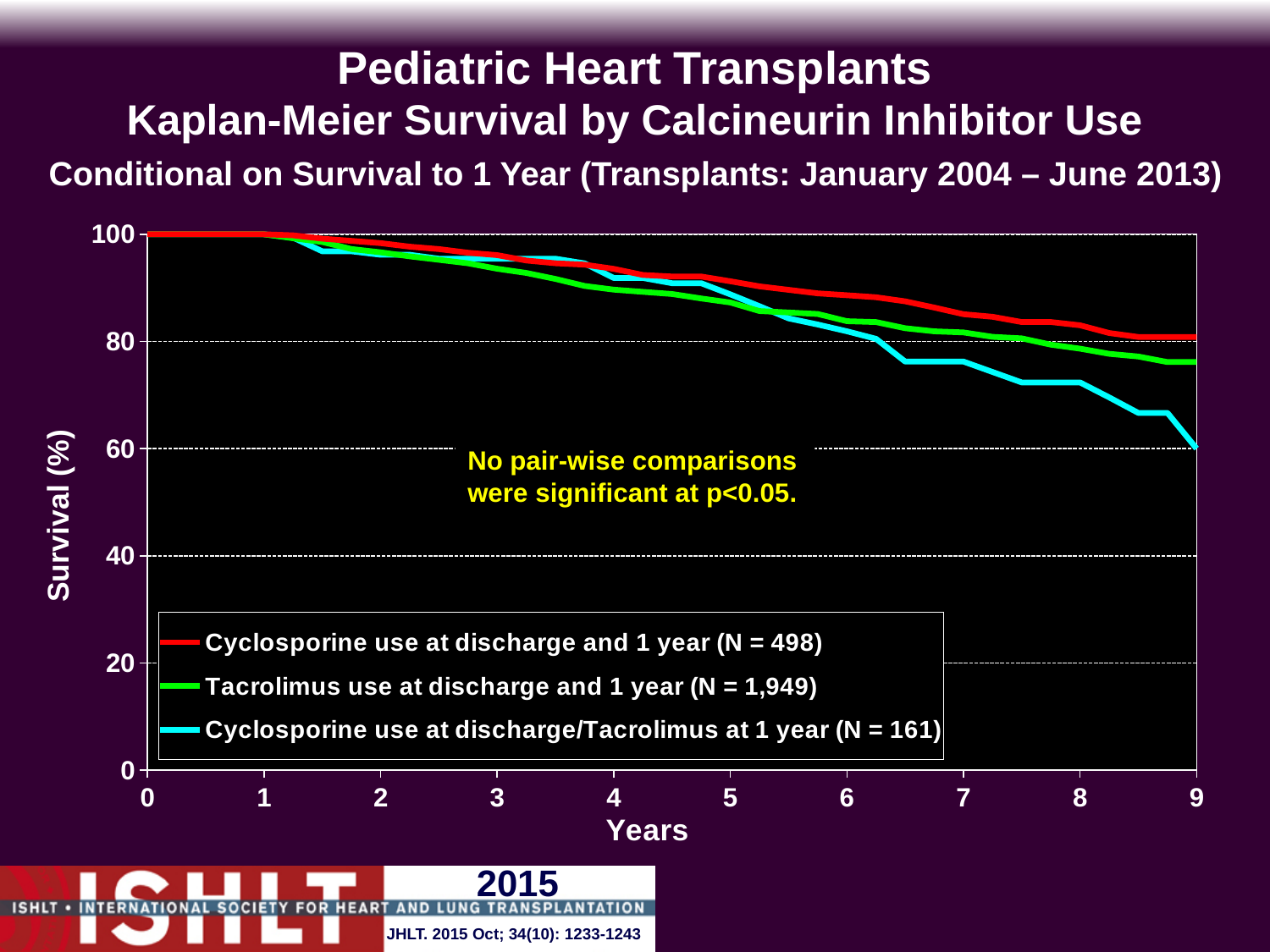
At 9 years, is survival for the Tacrolimus use at discharge and 1 year group greater or less than 80%? less Which series has the lowest survival at 9 years? Cyclosporine use at discharge/Tacrolimus at 1 year (N = 161) At 8 years, which group has higher survival: Tacrolimus use at discharge and 1 year, or Cyclosporine use at discharge/Tacrolimus at 1 year? Tacrolimus use at discharge and 1 year What kind of chart is shown on the slide? Line chart At 5 years, is survival for the Cyclosporine use at discharge and 1 year group greater or less than 80%? greater What is the N for the Tacrolimus use at discharge and 1 year group shown in the legend? N = 1,949 At 8 years, is survival for the Cyclosporine use at discharge/Tacrolimus at 1 year group greater or less than 60%? greater What colour is the line for Cyclosporine use at discharge and 1 year? Red Which series has the highest survival at 9 years? Cyclosporine use at discharge and 1 year (N = 498) Do the survival curves rise or fall as years increase? Fall How many series does the legend list? 3